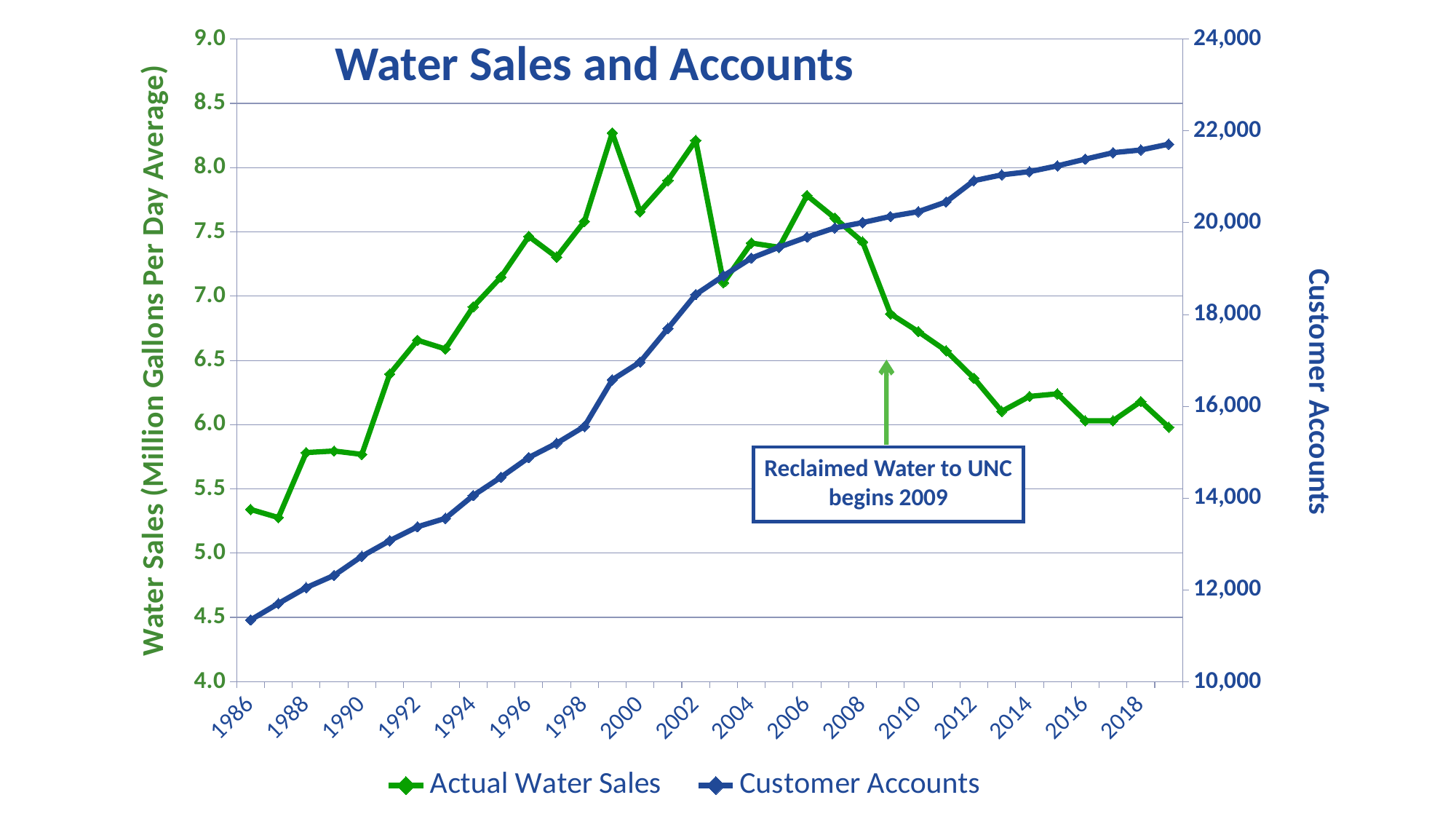
What kind of chart is shown on the slide? Line chart What is the title of the chart? Water Sales and Accounts Is the Customer Accounts value for 2019 greater or less than 20,000? greater What does the annotation box on the chart say? Reclaimed Water to UNC begins 2009 In which year is the Customer Accounts series at its highest? 2019 In which year is the Actual Water Sales series at its lowest? 1987 Is the Actual Water Sales value for 2019 greater or less than 6.5? less How many series does the legend list? 2 Is the Actual Water Sales value for 1999 greater or less than 8.0? greater Which is larger, the Actual Water Sales value for 1999 or for 2019? 1999 Does the Customer Accounts series rise or fall from 1986 to 2019? Rise